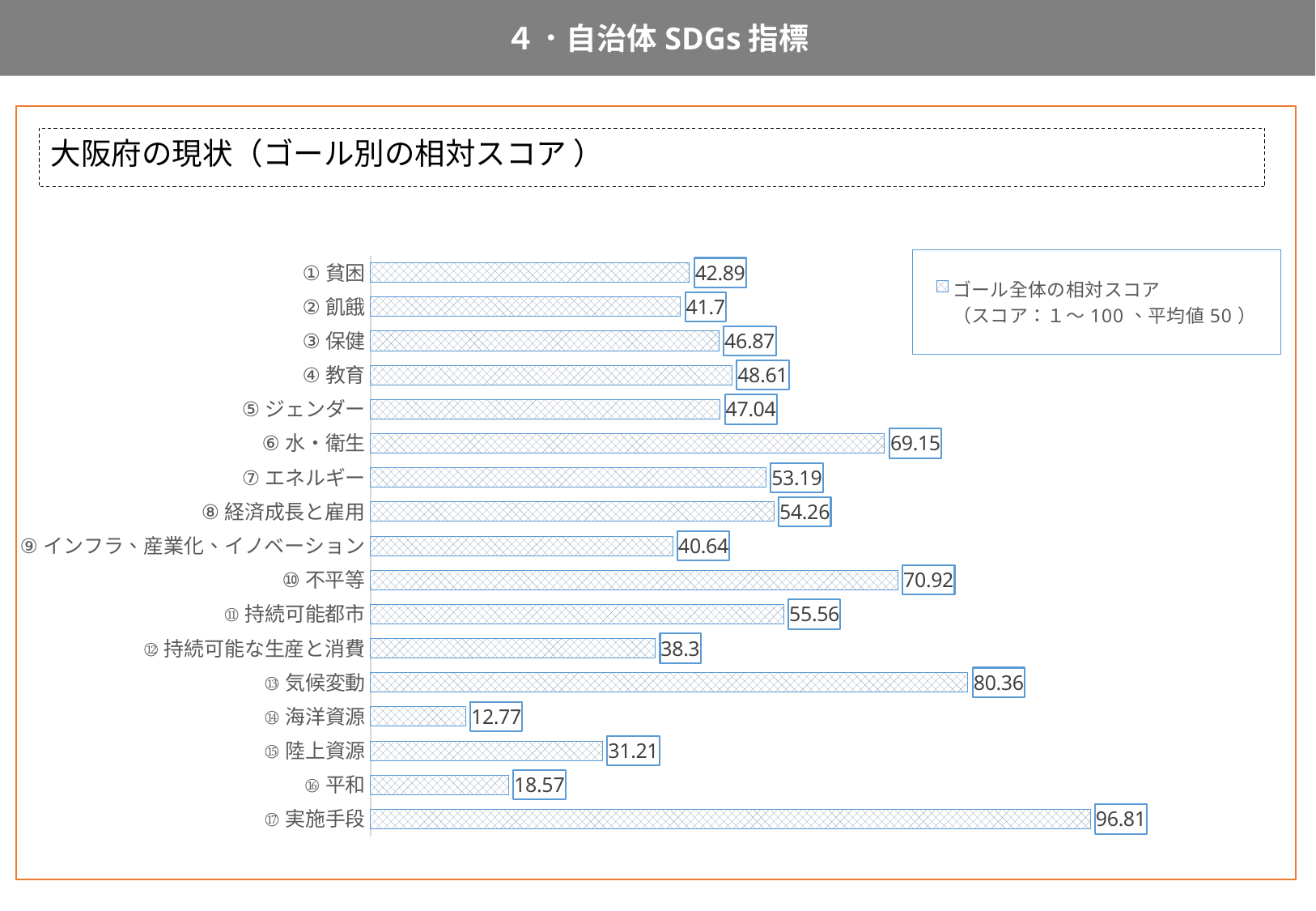
What is the value for ⑥ 水・衛生? 69.15 What is the value for ⑭ 海洋資源? 12.77 How many series does the legend list? 1 What is the legend entry for the series shown in the chart? ゴール全体の相対スコア（スコア：１～100、平均値50） What is the difference between the values for ⑰ 実施手段 and ⑭ 海洋資源? 84.04 How many categories are shown in the chart? 17 What is the difference between the values for ⑬ 気候変動 and ⑩ 不平等? 9.44 What kind of chart is shown on the slide? bar chart What is the value for ⑨ インフラ、産業化、イノベーション? 40.64 Which category has the highest value? ⑰ 実施手段 Which is larger, the value for ⑧ 経済成長と雇用 or the value for ⑦ エネルギー? ⑧ 経済成長と雇用 Which category has the lowest value? ⑭ 海洋資源